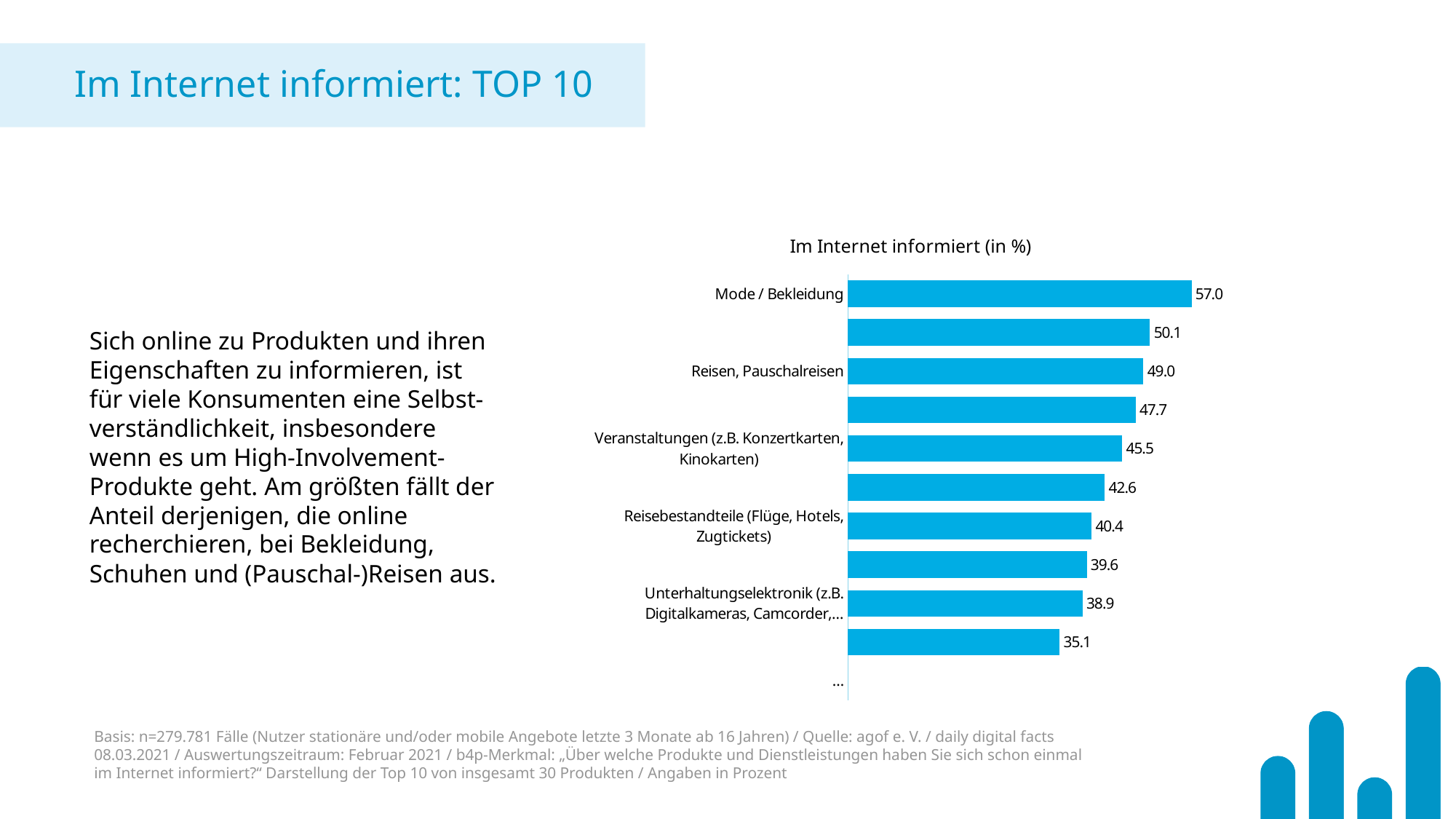
What is the value for Unterhaltungselektronik (z.B. Digitalkameras, Camcorder,...)? 38.9 What is the value for Veranstaltungen (z.B. Konzertkarten, Kinokarten)? 45.5 What is the value for Reisebestandteile (Flüge, Hotels, Zugtickets)? 40.4 What is the difference between the values for Mode / Bekleidung and Reisen, Pauschalreisen? 8.0 What kind of chart is shown on the slide? bar chart What is the smallest value shown on any bar in the chart? 35.1 What is the value for Reisen, Pauschalreisen? 49.0 How many bars are plotted in the chart? 10 What is the title of the chart? Im Internet informiert (in %) What is the value for Mode / Bekleidung? 57.0 Which is larger: the value for Veranstaltungen (z.B. Konzertkarten, Kinokarten) or for Reisebestandteile (Flüge, Hotels, Zugtickets)? Veranstaltungen (z.B. Konzertkarten, Kinokarten) Which category has the highest value in the chart? Mode / Bekleidung